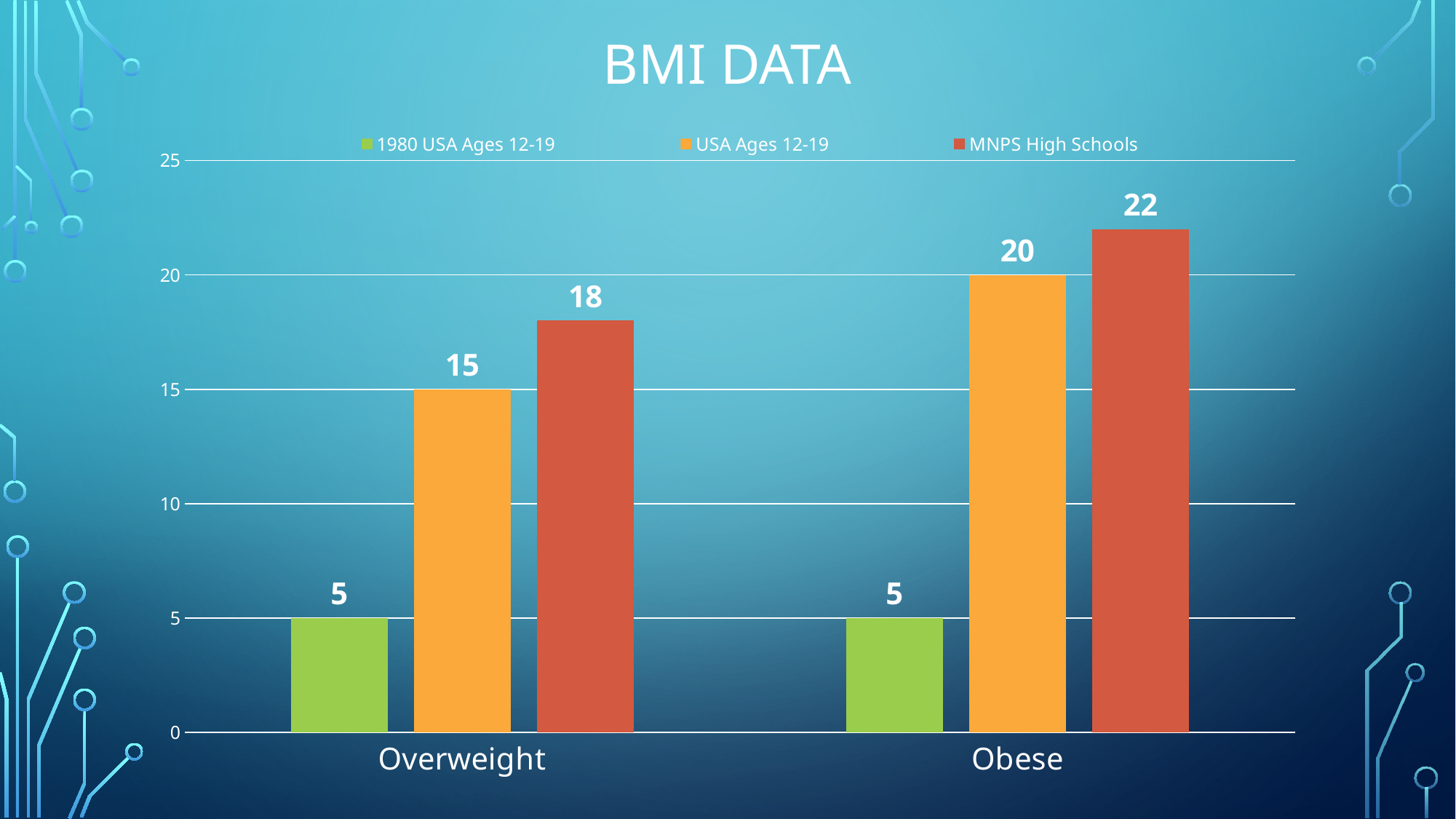
Which is larger: USA Ages 12-19 for Obese or MNPS High Schools for Overweight? USA Ages 12-19 for Obese What is the difference between USA Ages 12-19 and 1980 USA Ages 12-19 in the Obese category? 15 How many series does the legend list? 3 What is the value for MNPS High Schools in the Obese category? 22 What kind of chart is shown on the slide? Bar chart Which series has the highest value in the Overweight category? MNPS High Schools Which series has the lowest value in the Obese category? 1980 USA Ages 12-19 What is the value for USA Ages 12-19 in the Overweight category? 15 How many categories are shown on the x axis? 2 What is the value for 1980 USA Ages 12-19 in the Obese category? 5 What is the difference between the MNPS High Schools values for Obese and Overweight? 4 What is the title of the chart? BMI DATA